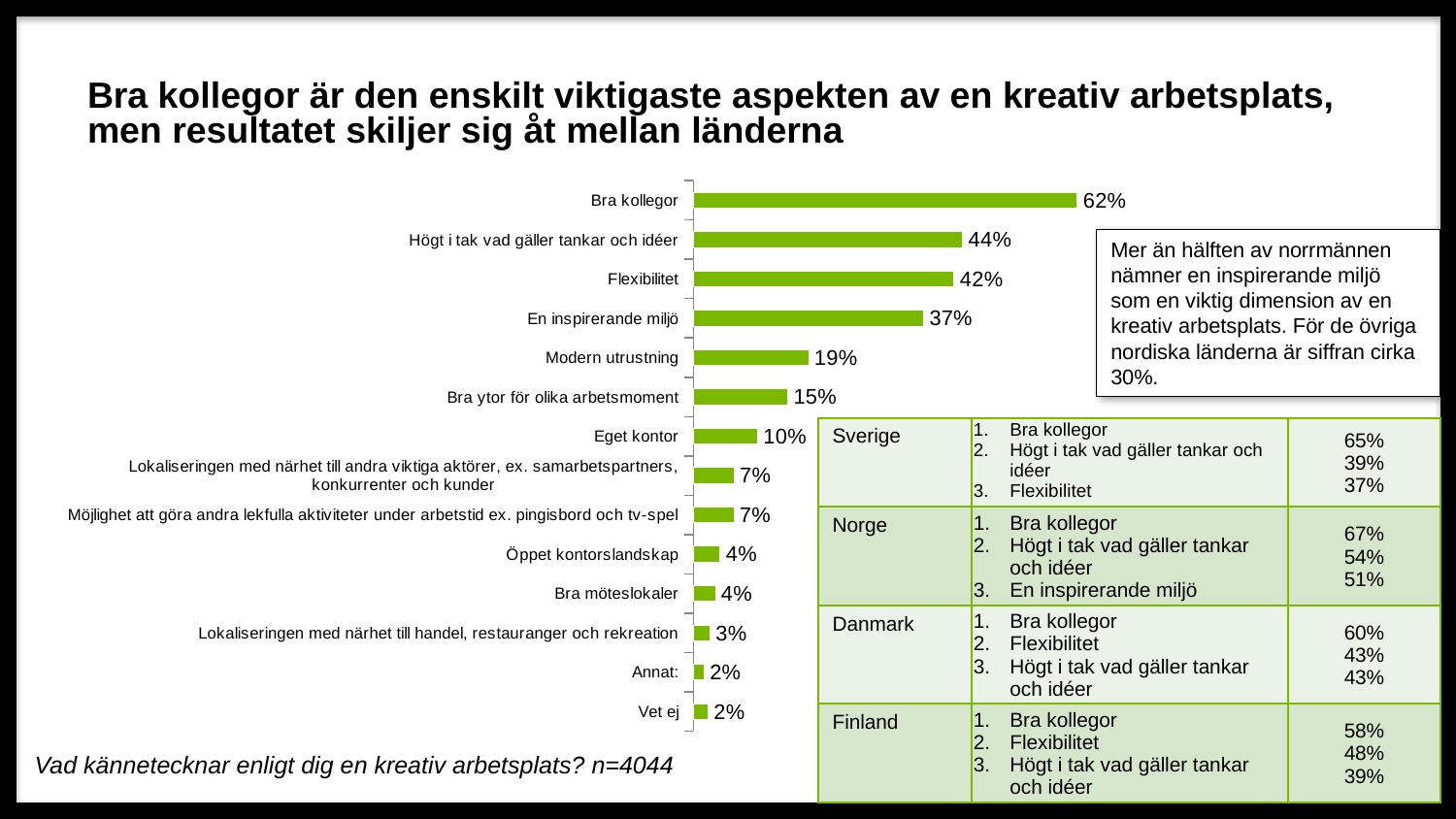
What is the value for "En inspirerande miljö"? 37% What sample size (n) is stated below the chart? n=4044 What is the difference between "Modern utrustning" and "Bra ytor för olika arbetsmoment"? 4% What is the value for "Modern utrustning"? 19% What is the value for "Flexibilitet"? 42% What is the value for "Bra kollegor"? 62% Which category has the highest value? Bra kollegor What is the difference between "Bra kollegor" and "Högt i tak vad gäller tankar och idéer"? 18% What kind of chart is shown on the slide? bar chart Which is larger, "Flexibilitet" or "En inspirerande miljö"? Flexibilitet What is the value for "Eget kontor"? 10% How many categories are shown in the bar chart? 14